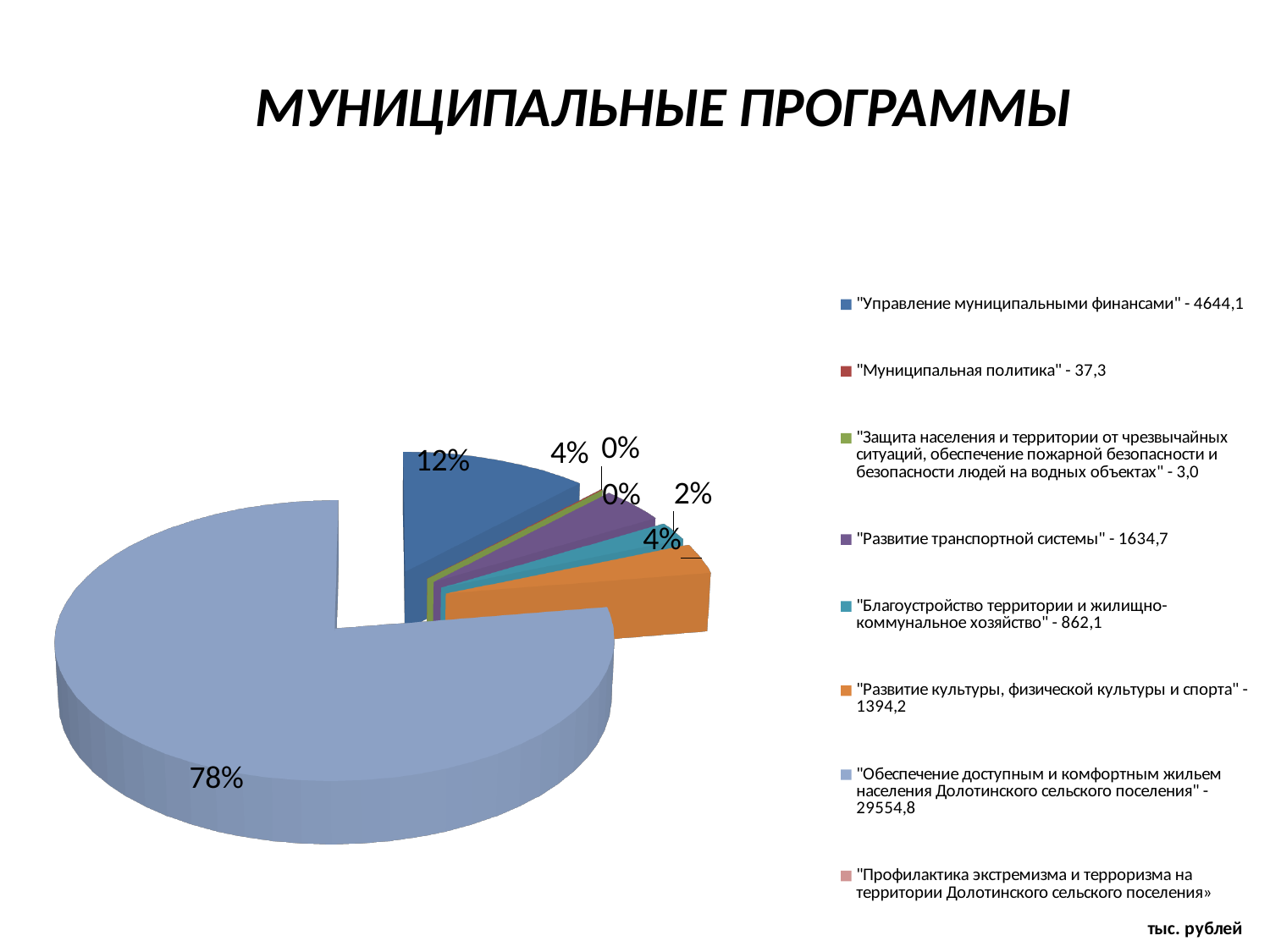
What share of the pie does "Управление муниципальными финансами" take? 12% How many entries does the legend list? 8 What is the difference between the legend values for "Управление муниципальными финансами" and "Развитие транспортной системы"? 3009,4 What kind of chart is shown on the slide? pie chart What share of the pie does "Обеспечение доступным и комфортным жильем населения Долотинского сельского поселения" take? 78% What value is given in the legend for "Развитие транспортной системы"? 1634,7 Which program has the largest slice of the pie? "Обеспечение доступным и комфортным жильем населения Долотинского сельского поселения" What value is given in the legend for "Муниципальная политика"? 37,3 What is the title of the chart? МУНИЦИПАЛЬНЫЕ ПРОГРАММЫ What value is given in the legend for "Благоустройство территории и жилищно-коммунальное хозяйство"? 862,1 Which is larger: the value for "Развитие культуры, физической культуры и спорта" or for "Благоустройство территории и жилищно-коммунальное хозяйство"? "Развитие культуры, физической культуры и спорта" In what units are the values given, according to the note at the bottom right of the slide? тыс. рублей